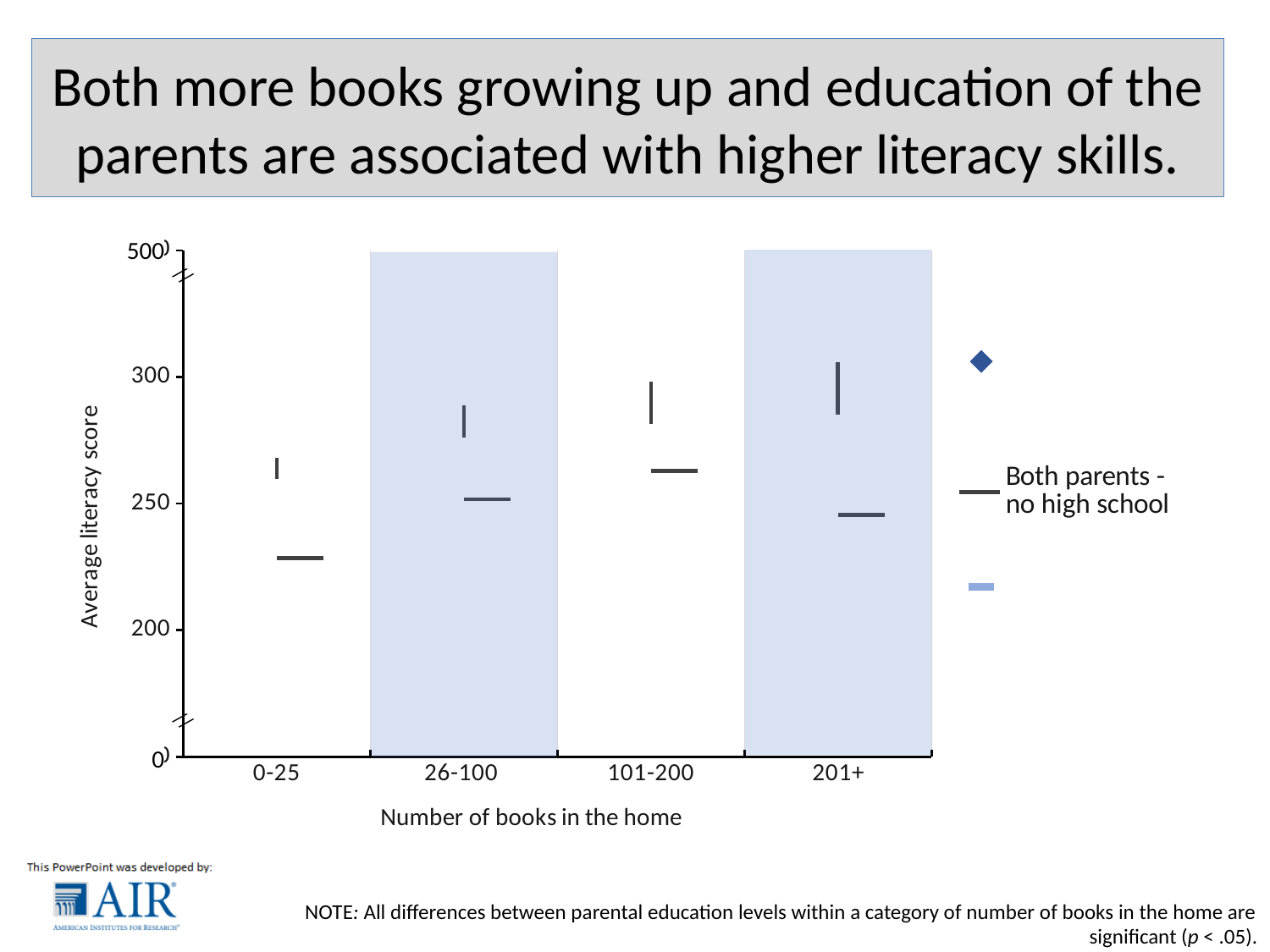
Is the value for Both parents - no high school in the 0-25 books category greater or less than 200? greater For Both parents - no high school, which category has the larger value: 0-25 or 101-200 books? 101-200 For Both parents - no high school, which category has the larger value: 0-25 or 26-100 books? 26-100 Is the value for Both parents - no high school in the 0-25 books category greater or less than 250? less Does the value for Both parents - no high school rise or fall from the 0-25 category to the 101-200 category? rises What is the title of the y axis? Average literacy score Which number-of-books category has the lowest value for Both parents - no high school? 0-25 How many number-of-books categories are shown on the x axis? 4 What is the title of the x axis? Number of books in the home Is the value for Both parents - no high school in the 101-200 books category greater or less than 250? greater Which number-of-books category has the highest value for Both parents - no high school? 101-200